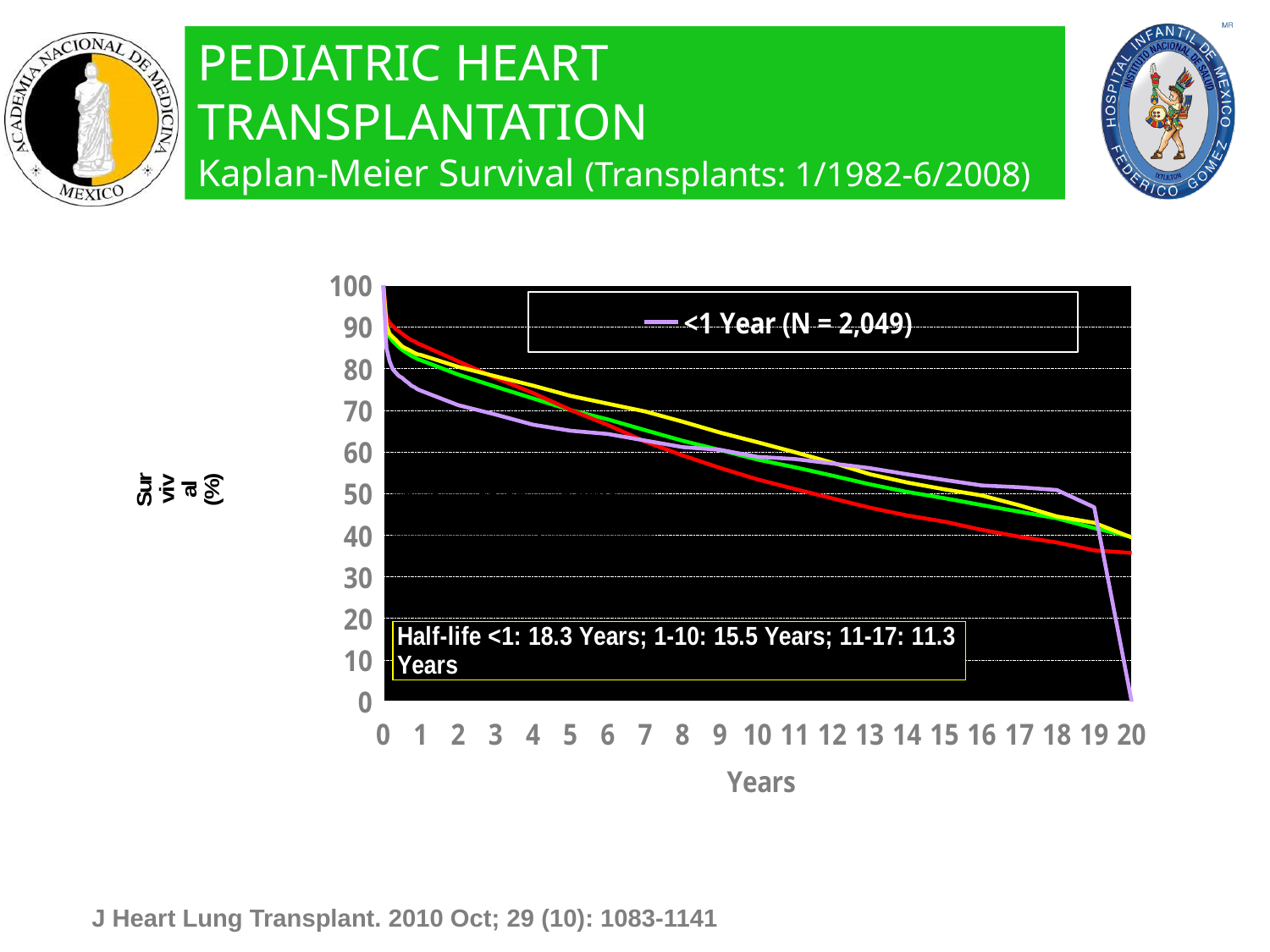
Is the survival value for the <1 Year series at 2 years greater or less than 80? less How many series does the chart legend list? 1 According to the annotation on the chart, what is the half-life for the 11-17 group? 11.3 Years What is the N value given in the legend for the <1 Year series? 2,049 According to the annotation on the chart, what is the half-life for the <1 group? 18.3 Years What is the label of the x axis? Years What kind of chart is shown on the slide? Line chart Is the survival value for the <1 Year series at 10 years greater or less than 50? greater Is the survival value for the <1 Year series at 5 years greater or less than 60? greater Does survival for the <1 Year series rise or fall as years increase? Fall What is the label of the y axis? Survival (%)